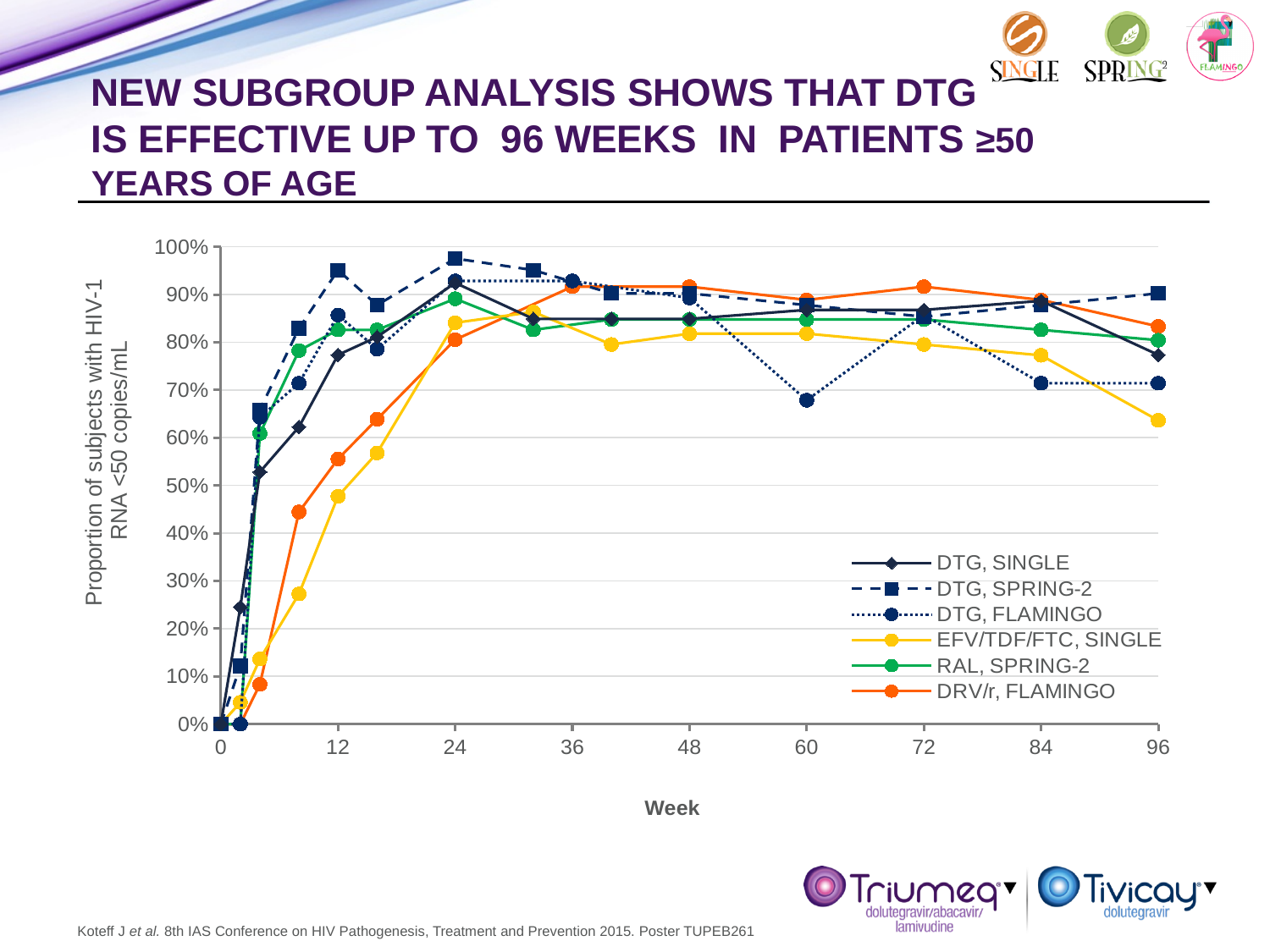
How many series does the legend list? 6 What kind of chart is shown on the slide? Line chart At week 60, which is larger: DRV/r, FLAMINGO or DTG, FLAMINGO? DRV/r, FLAMINGO Is the value for DTG, SPRING-2 at week 24 greater or less than 90%? greater Is the value for EFV/TDF/FTC, SINGLE at week 96 greater or less than 70%? less What is the label of the y axis? Proportion of subjects with HIV-1 RNA <50 copies/mL Does the DTG, SPRING-2 series rise or fall between week 0 and week 24? Rise Which series has the lowest value at week 60? DTG, FLAMINGO Is the value for DRV/r, FLAMINGO at week 8 greater or less than 50%? less What is the label of the x axis? Week Which series has the highest value at week 96? DTG, SPRING-2 Which series has the lowest value at week 96? EFV/TDF/FTC, SINGLE